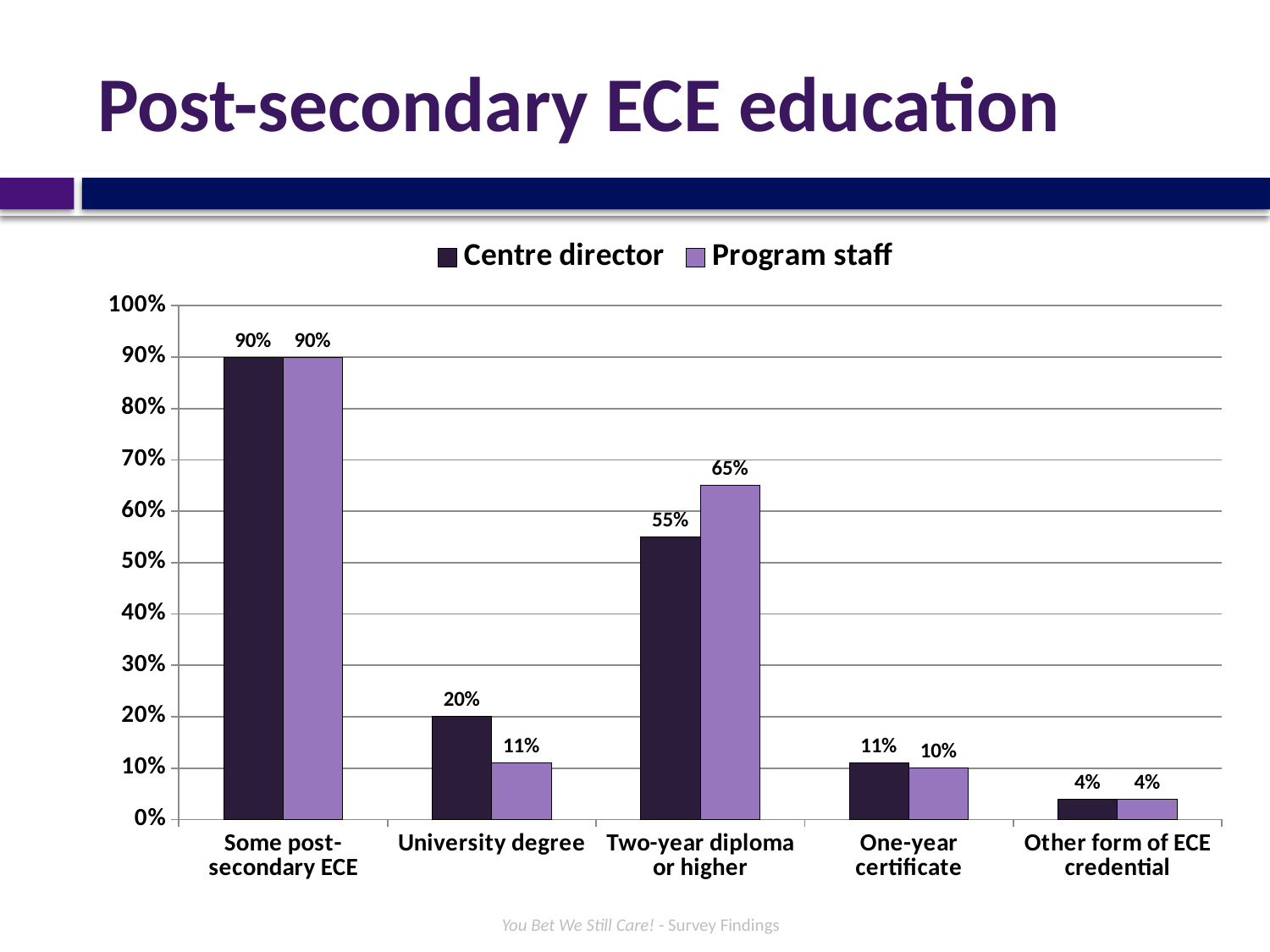
What is the value for Program staff in the One-year certificate category? 10% Which category has the lowest value for Program staff? Other form of ECE credential What is the value for Program staff in the Two-year diploma or higher category? 65% What is the difference between Centre director and Program staff in the University degree category? 9% What is the title of the slide? Post-secondary ECE education How many series does the legend list? 2 How many categories are shown on the x axis? 5 What kind of chart is shown on the slide? Bar chart In the Two-year diploma or higher category, which series has the larger value, Centre director or Program staff? Program staff Which category has the highest value for Centre director? Some post-secondary ECE What is the difference between Program staff and Centre director in the Two-year diploma or higher category? 10% What is the value for Centre director in the University degree category? 20%